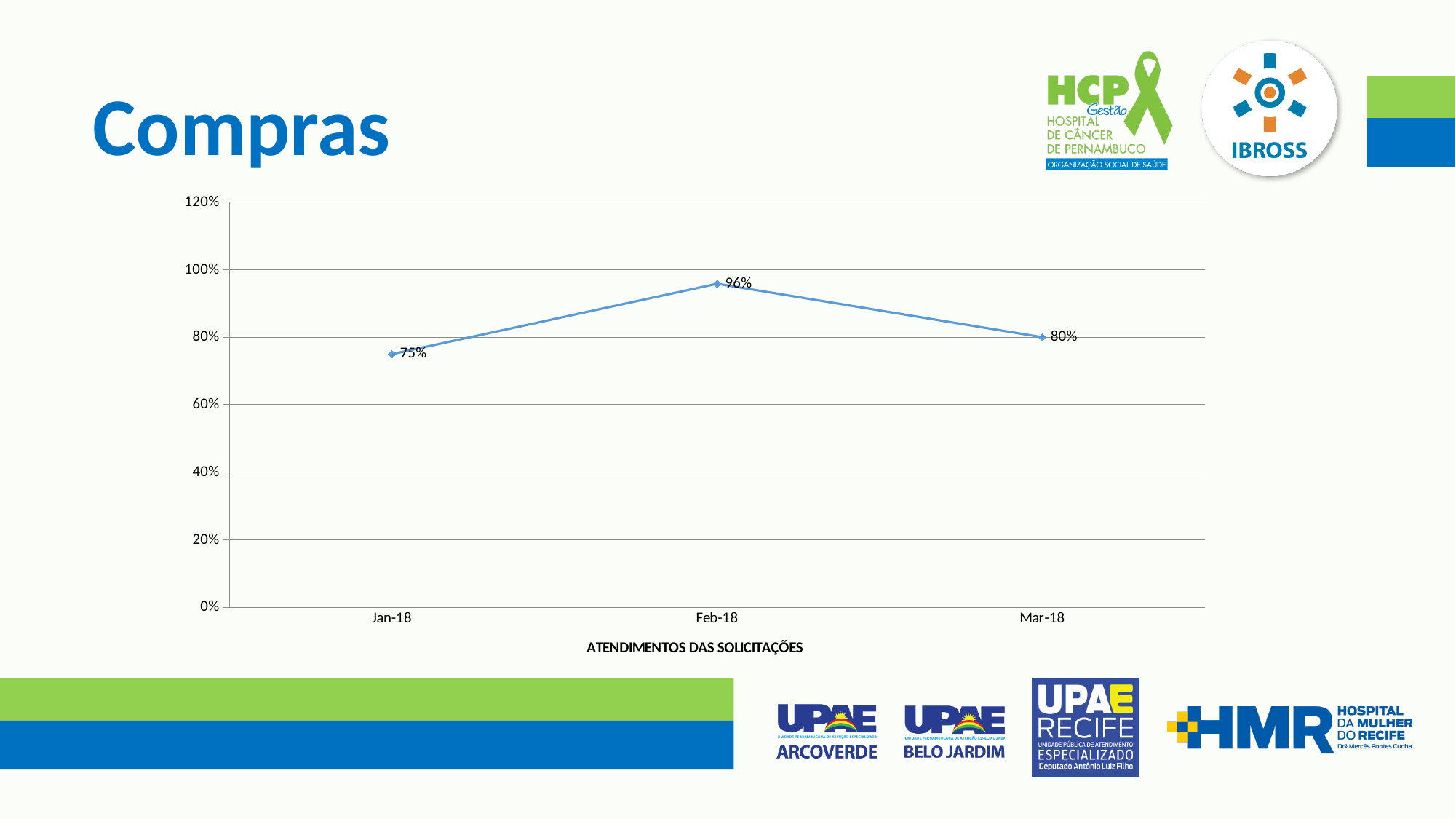
What is the value for Jan-18? 75% What is the difference between the values for Feb-18 and Jan-18? 21% What kind of chart is shown on the slide? Line chart Which month has the lowest value? Jan-18 What is the value for Mar-18? 80% Is the value for Feb-18 greater or less than 80%? greater What is the label shown below the x axis of the chart? ATENDIMENTOS DAS SOLICITAÇÕES Which is larger, the value for Mar-18 or the value for Jan-18? Mar-18 What is the value for Feb-18? 96% How many data points are plotted on the chart? 3 What is the difference between the values for Feb-18 and Mar-18? 16% Which month has the highest value? Feb-18